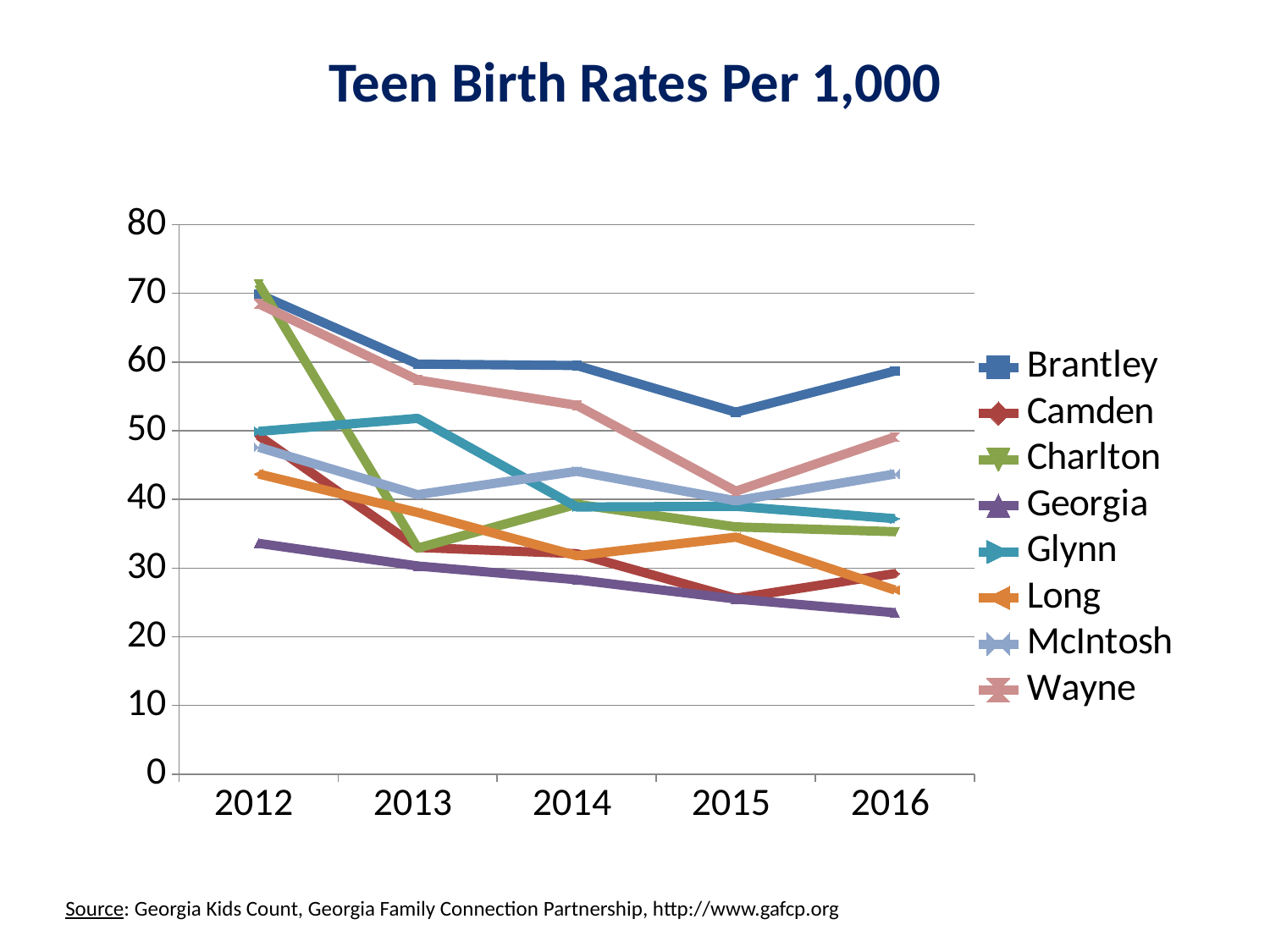
Is the value for Georgia in 2016 greater or less than 30? less What kind of chart is shown on the slide? line chart How many series does the legend list? 8 Is the value for Long in 2016 greater or less than 30? less Is the value for Glynn in 2013 greater or less than 50? greater Does the Georgia line rise or fall from 2012 to 2016? fall Which series has the lowest value in 2016? Georgia In 2014, which is larger, the value for Wayne or the value for Glynn? Wayne Which series has the highest value in 2016? Brantley What is the title of the chart? Teen Birth Rates Per 1,000 How many years are shown on the x axis? 5